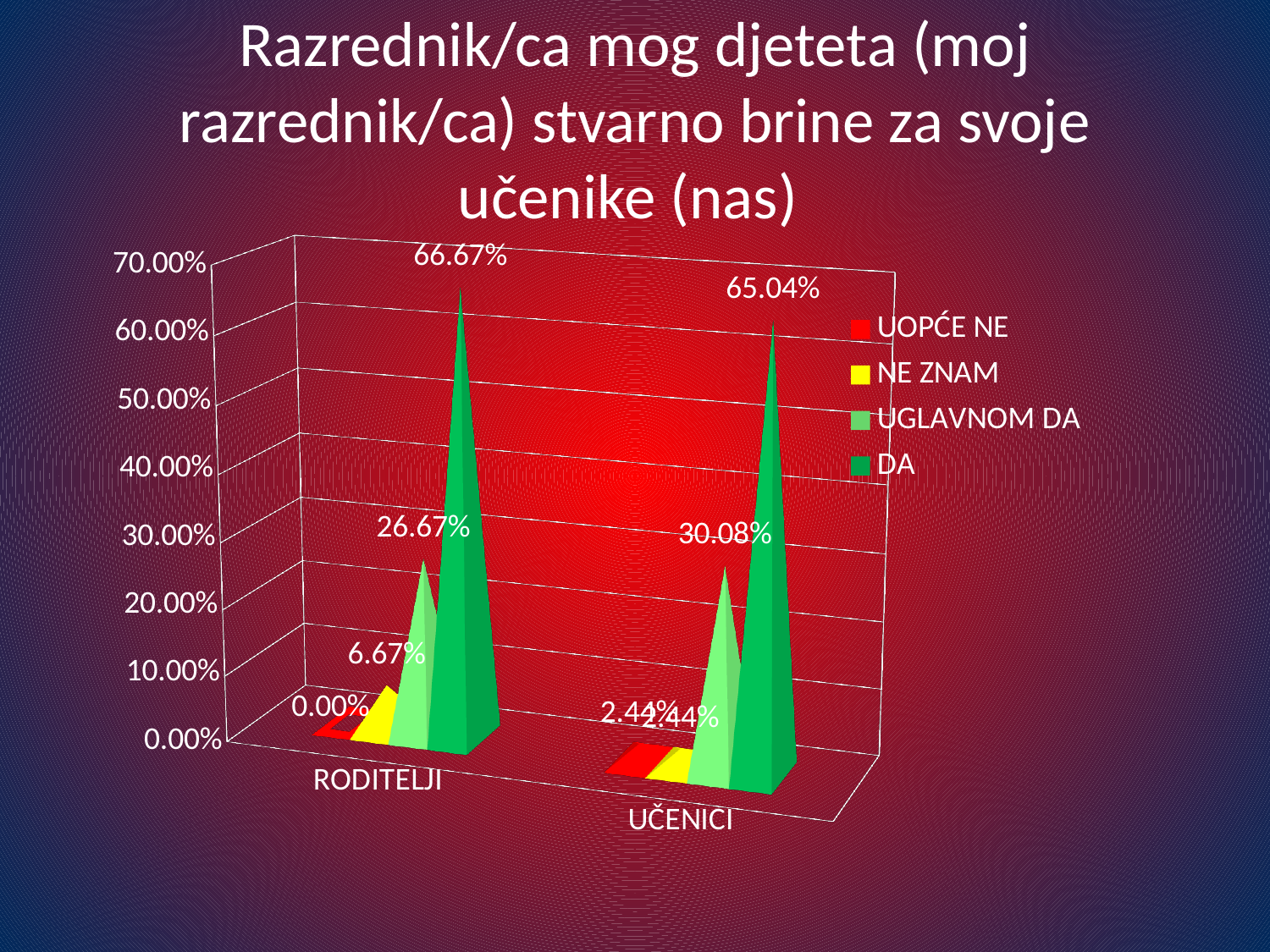
What kind of chart is shown on the slide? bar chart How many series does the legend list? 4 What is the value for UGLAVNOM DA in the UČENICI category? 30.08% Which category has the larger value for DA, RODITELJI or UČENICI? RODITELJI What is the value for DA in the RODITELJI category? 66.67% What is the value for DA in the UČENICI category? 65.04% What is the value for UOPĆE NE in the RODITELJI category? 0.00% Which series has the highest value in the RODITELJI category? DA What is the difference between the UGLAVNOM DA values for UČENICI and RODITELJI? 3.41% What is the value for UGLAVNOM DA in the RODITELJI category? 26.67% How many categories are shown on the x axis? 2 What is the value for NE ZNAM in the RODITELJI category? 6.67%